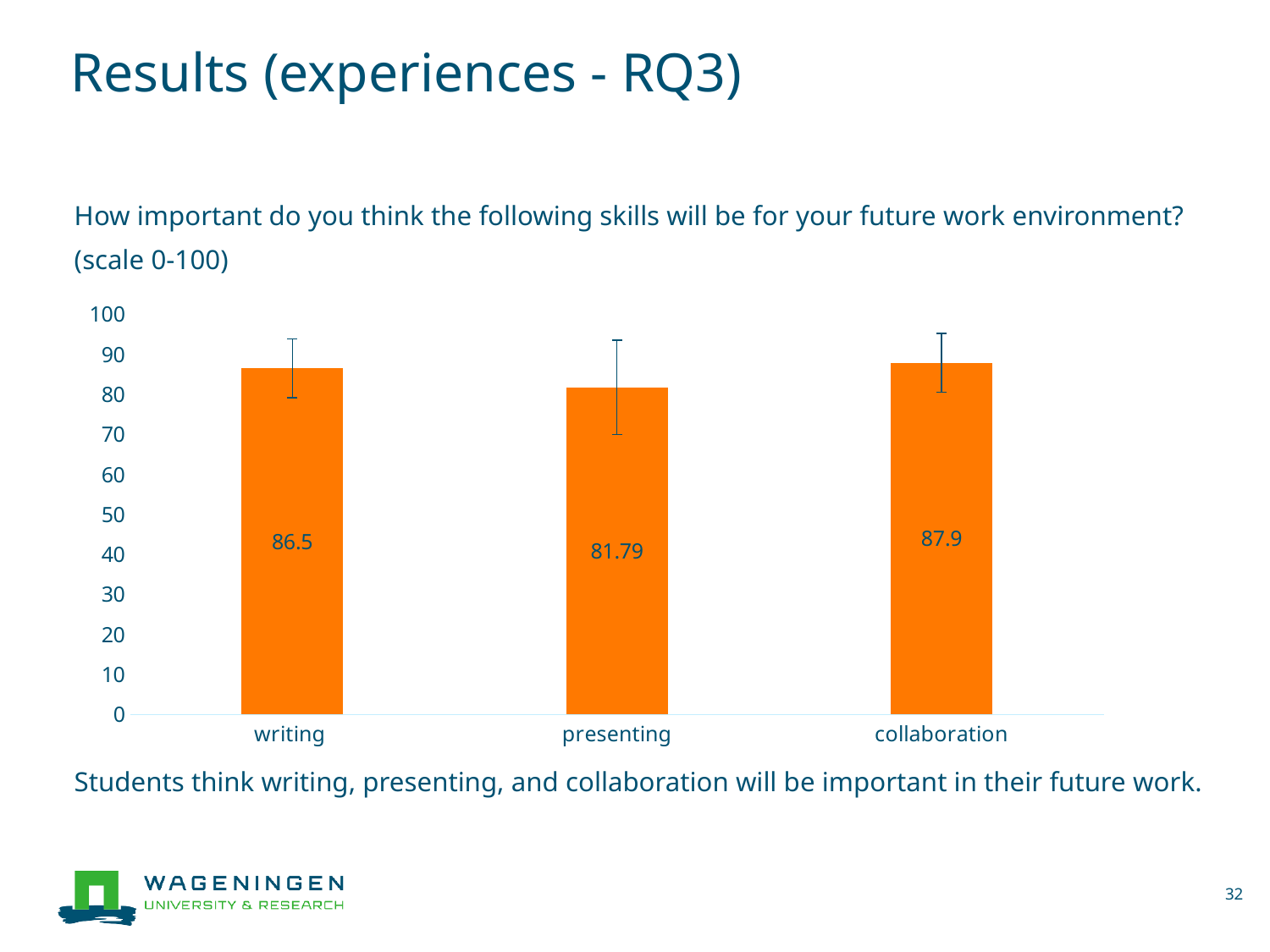
What kind of chart is shown on the slide? bar chart What is the maximum value shown on the vertical axis? 100 Which is larger, the value for writing or the value for presenting? writing Is the value for presenting greater or less than 90? less Which skill has the lowest value? presenting Which skill has the highest value? collaboration What is the value for collaboration? 87.9 What is the value for writing? 86.5 What is the difference between the values for collaboration and presenting? 6.11 What is the difference between the values for writing and presenting? 4.71 How many skills are shown on the chart? 3 What is the value for presenting? 81.79